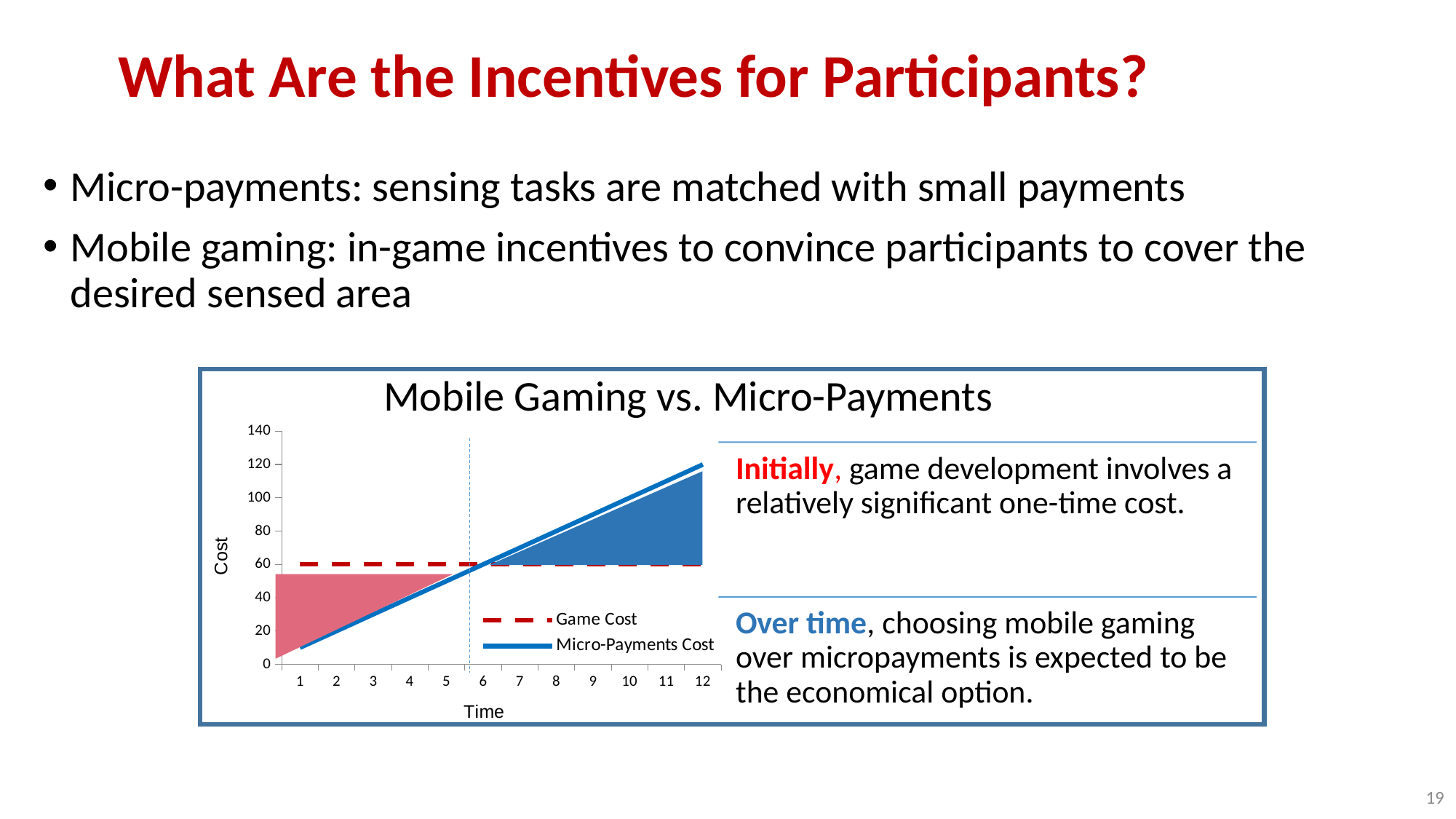
Does the Game Cost series rise, fall, or stay flat as Time increases? Stays flat How many time points are shown along the x axis of the chart? 12 What is the value of the Game Cost series on the chart? 60 What is the title of the chart? Mobile Gaming vs. Micro-Payments At Time 12, which series has the larger value, Game Cost or Micro-Payments Cost? Micro-Payments Cost Is the Micro-Payments Cost at Time 1 greater or less than 40? less At Time 2, which series has the larger value, Game Cost or Micro-Payments Cost? Game Cost What is the label of the chart's y axis? Cost Is the Micro-Payments Cost at Time 12 greater or less than 100? greater What kind of chart is shown on the slide? Line chart Does the Micro-Payments Cost series rise or fall as Time increases? Rises How many series does the chart's legend list? 2